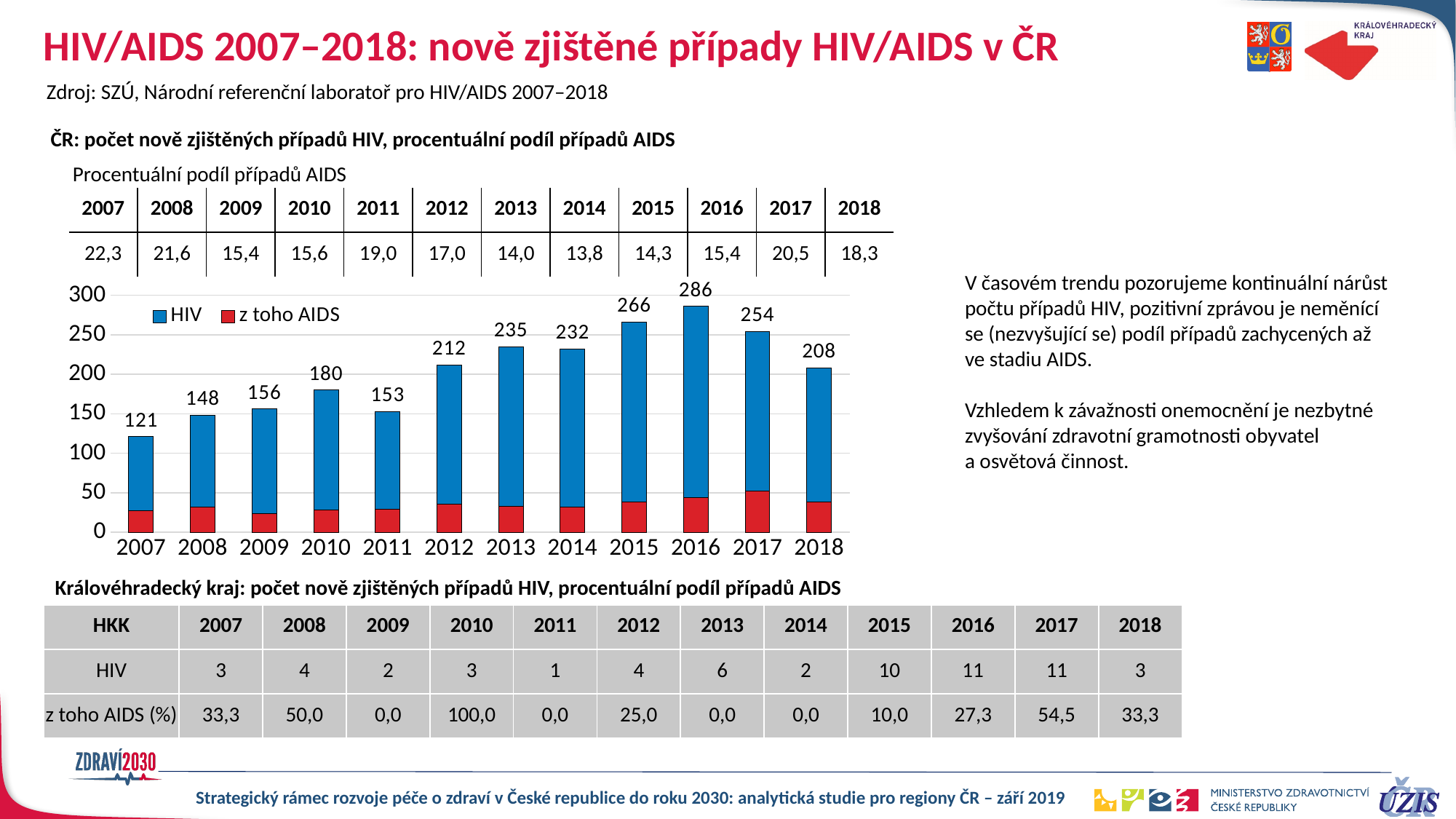
What is the HIV value for 2016 in the chart? 286 Does the HIV value rise or fall from 2017 to 2018? fall Which year has the larger HIV value, 2013 or 2014? 2013 What is the difference between the HIV values for 2016 and 2007? 165 What are the two series named in the chart legend? HIV; z toho AIDS What type of chart is shown on the slide? bar chart What is the HIV value for 2010 in the chart? 180 Which year has the highest HIV value in the chart? 2016 Is the 'z toho AIDS' value for 2017 greater or less than 100? less How many series does the chart legend list? 2 How many years are shown on the x axis of the chart? 12 Which year has the lowest HIV value in the chart? 2007